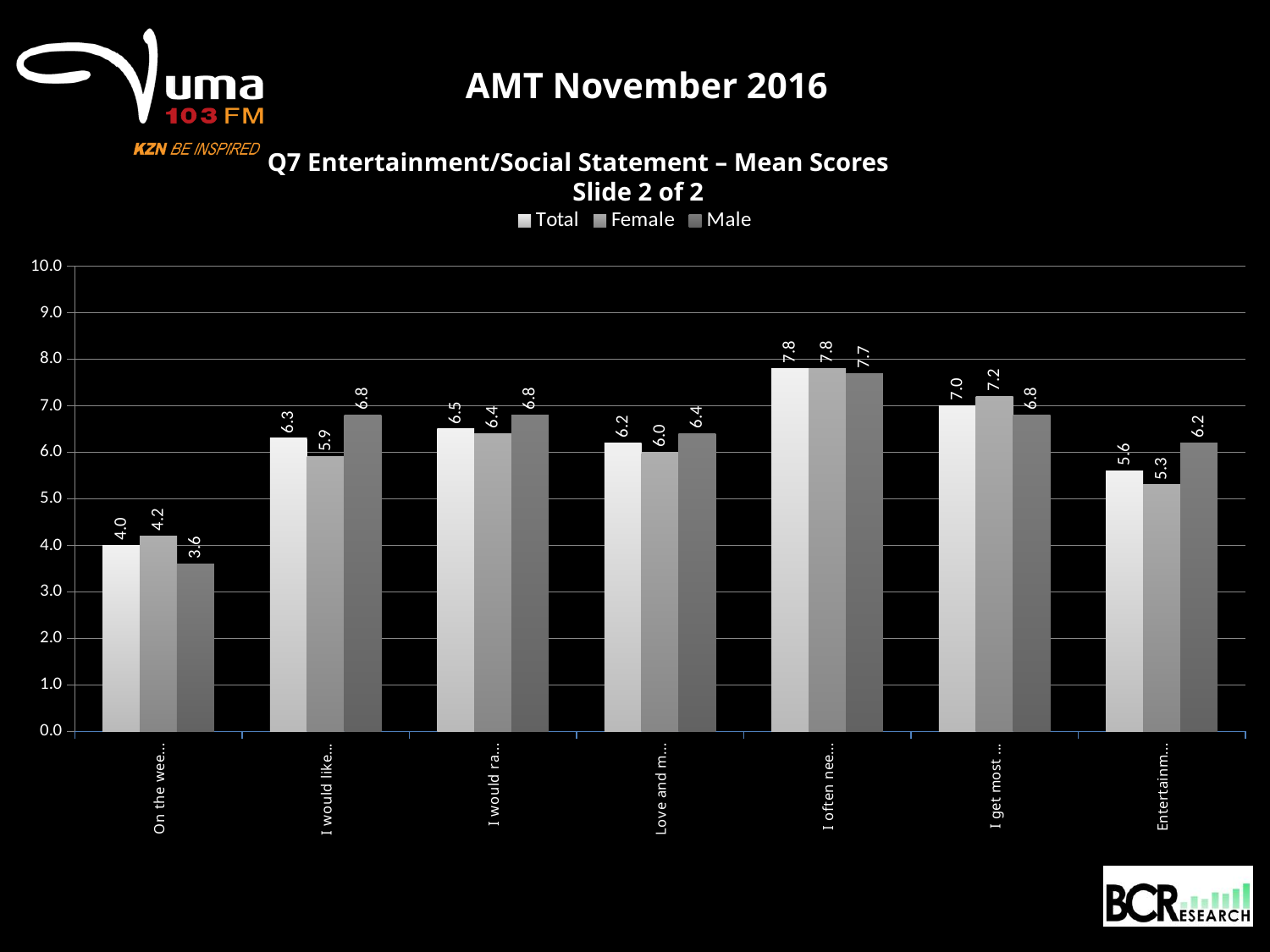
What kind of chart is shown on the slide? Bar chart What is the Male mean score for the last category, labelled 'Entertainm...'? 6.2 How many statement categories are plotted along the x axis? 7 What is the title of the chart? Q7 Entertainment/Social Statement – Mean Scores Slide 2 of 2 What is the Total mean score for the category labelled 'I often nee...'? 7.8 For the category labelled 'Entertainm...', which is larger, the Female or the Male mean score? Male Which category has the lowest Total mean score? On the wee... Which category has the highest Total mean score? I often nee... What is the Female mean score for the category labelled 'I get most ...'? 7.2 What is the Male mean score for the first category, labelled 'On the wee...'? 3.6 How many series does the legend list? 3 What is the difference between the Male and Female mean scores for the category labelled 'I would like...'? 0.9